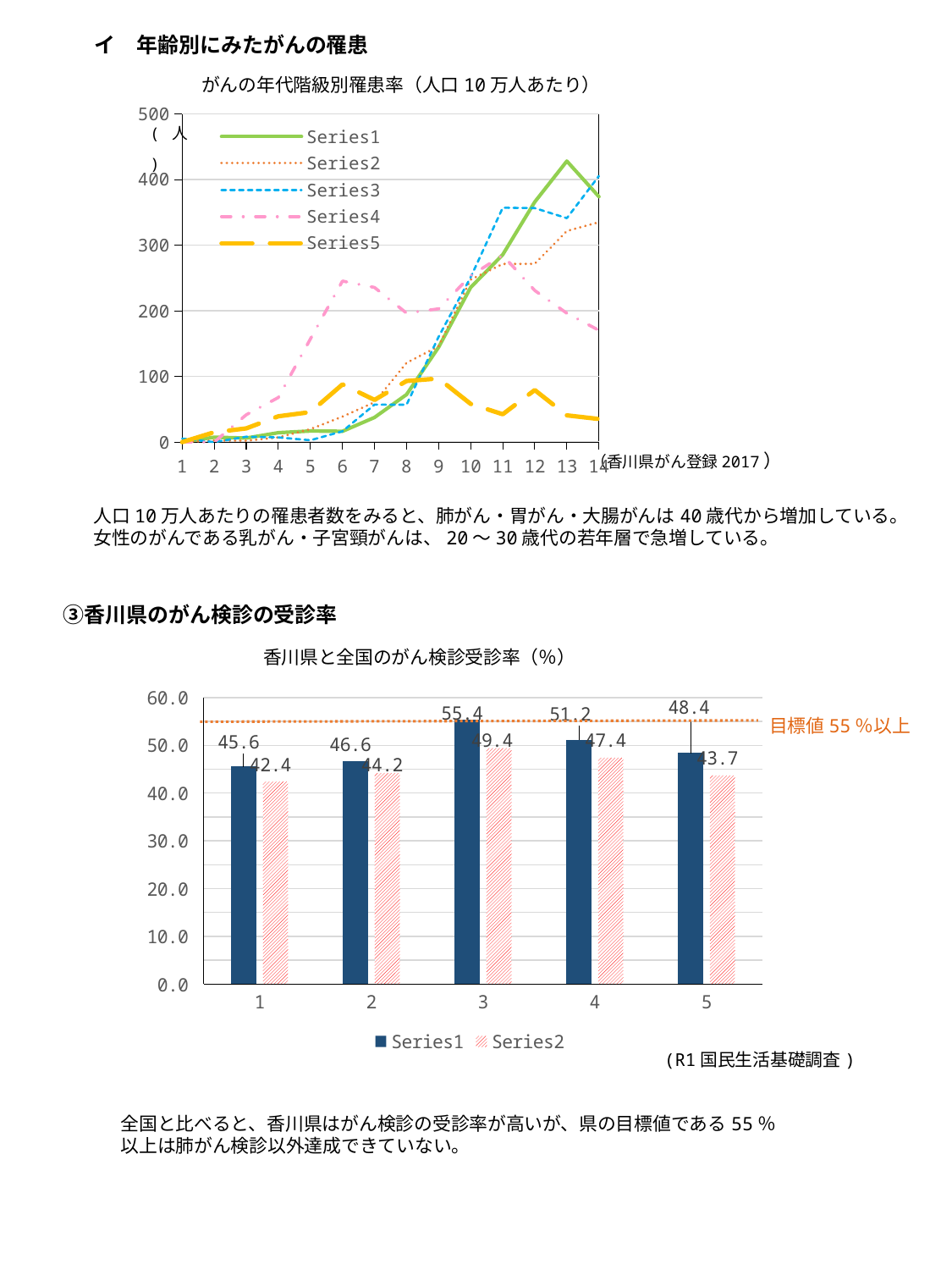
In the bottom chart, for category 4, which series has the larger value, Series1 or Series2? Series1 In the bottom chart, which category has the highest Series1 value? 3 In the bottom chart, what is the difference between Series1 and Series2 for category 3? 6.0 In the bottom chart, which category has the lowest Series2 value? 1 How many series does the legend of the top chart list? 5 What kind of chart is the top chart titled がんの年代階級別罹患率（人口10万人あたり）? line chart How many series does the legend of the bottom chart list? 2 In the bottom chart, what is the value of Series2 for category 5? 43.7 What kind of chart is the bottom chart titled 香川県と全国のがん検診受診率（%）? bar chart In the bottom chart, what is the value of Series1 for category 3? 55.4 How many categories are shown on the x axis of the bottom chart? 5 In the top chart, is the value of Series4 at point 6 greater or less than 200? greater